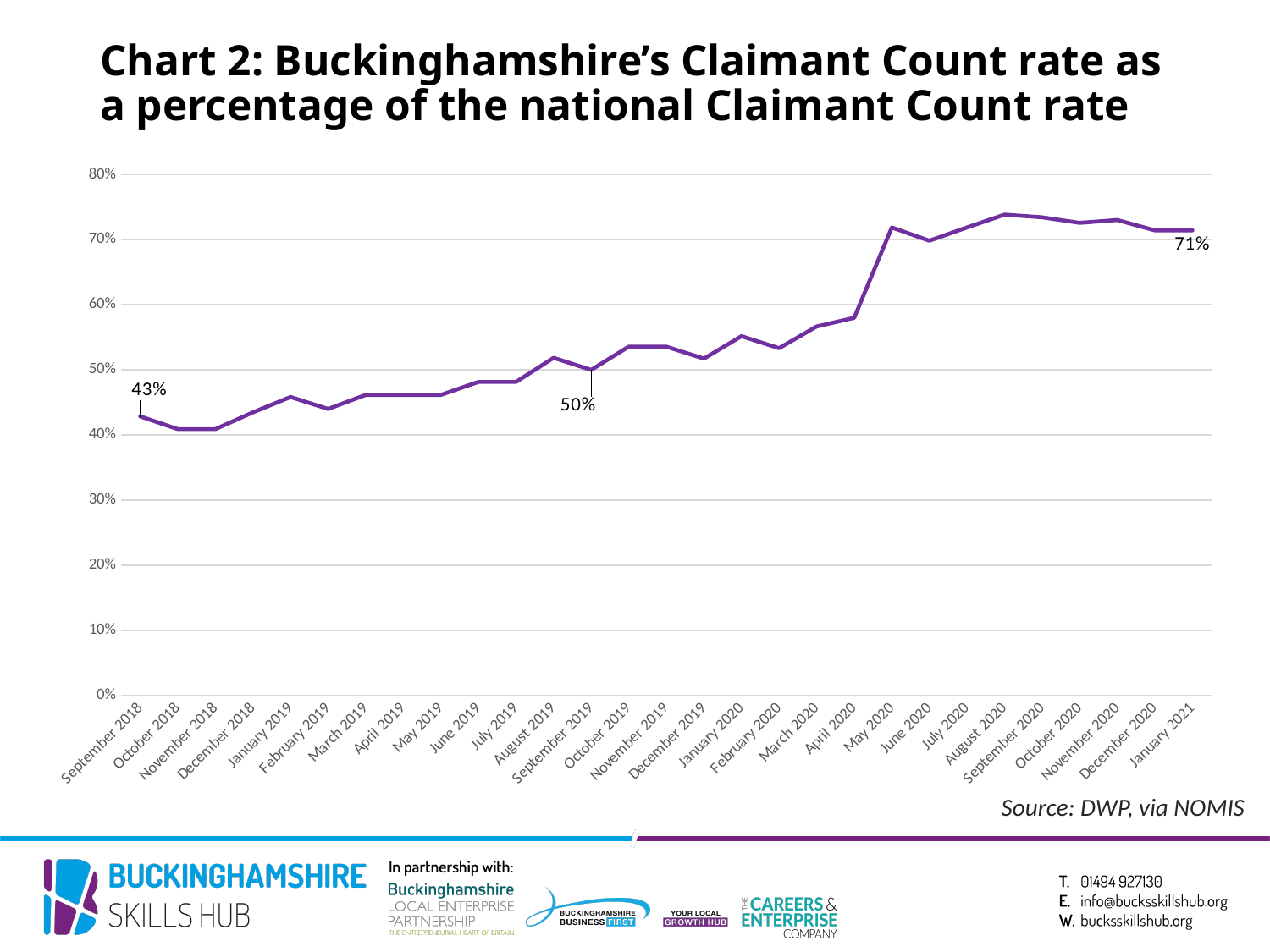
What is the value for September 2018? 43% What is the difference between the values for January 2021 and September 2018? 28 percentage points What is the difference between the values for September 2019 and September 2018? 7 percentage points What type of chart is shown on the slide? line chart Is the value for March 2020 greater or less than 50%? greater How many months are plotted on the x axis? 29 Is the value for October 2018 greater or less than 50%? less Which is larger, the value for January 2021 or the value for September 2018? January 2021 What is the value for January 2021? 71% What is the value for September 2019? 50% Is the value for August 2020 greater or less than 70%? greater Overall, do the values rise or fall from September 2018 to January 2021? rise